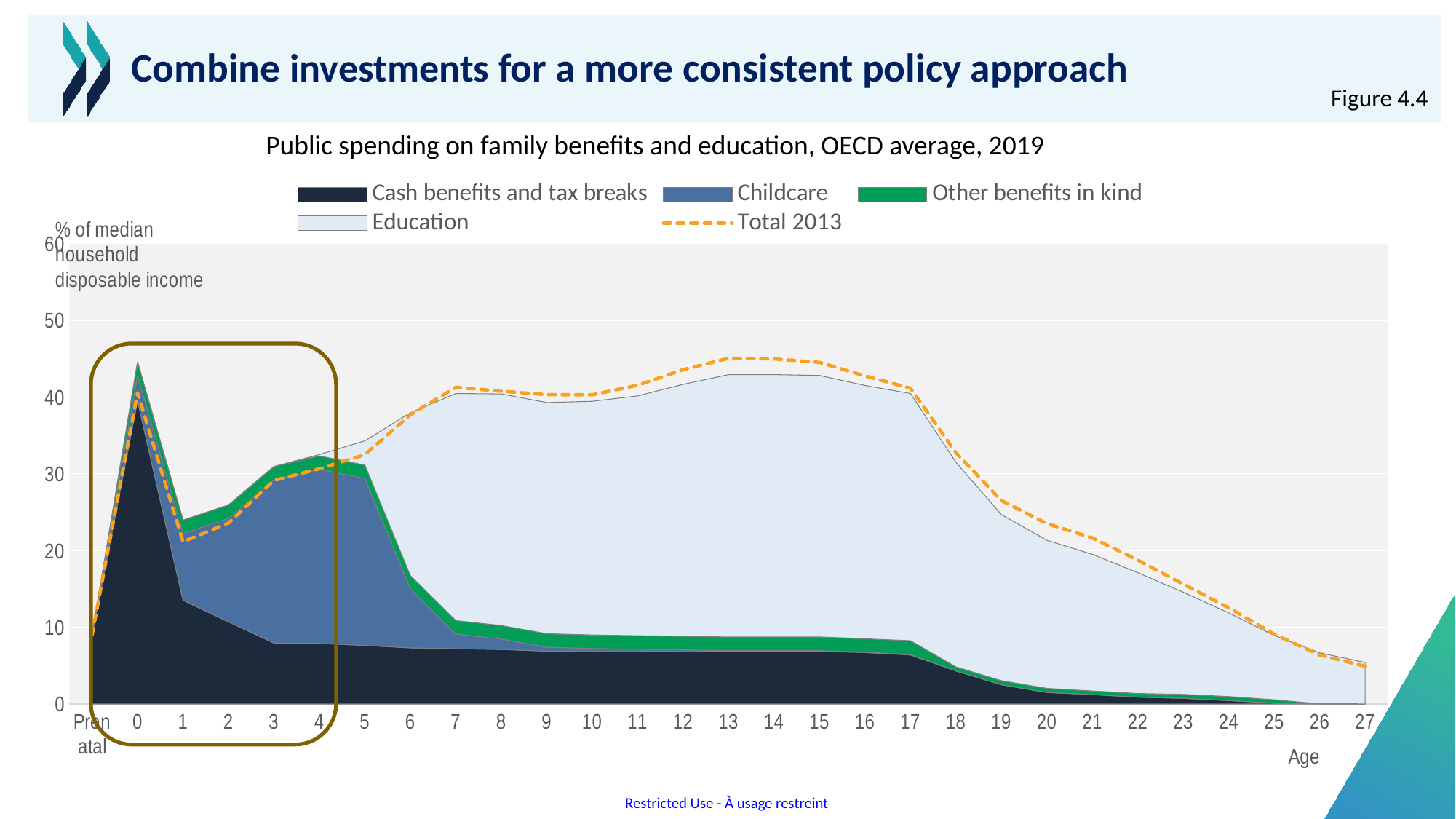
How many age categories are shown along the x axis, including Prenatal? 29 At which age is the total stacked spending lowest? 27 Do the total stacked spending values rise or fall from age 17 to age 27? Fall Is the total stacked spending at age 13 greater or less than 40? greater What is the unit shown on the y axis of the chart? % of median household disposable income Is the Total 2013 value at age 14 greater or less than 40? greater How many series does the chart's legend list? 5 Is the total stacked spending at age 27 greater or less than 10? less What kind of chart is shown on the slide? Stacked area chart with a dashed line What is the title of the chart? Public spending on family benefits and education, OECD average, 2019 Which is larger, the Total 2013 value at age 0 or at age 1? Age 0